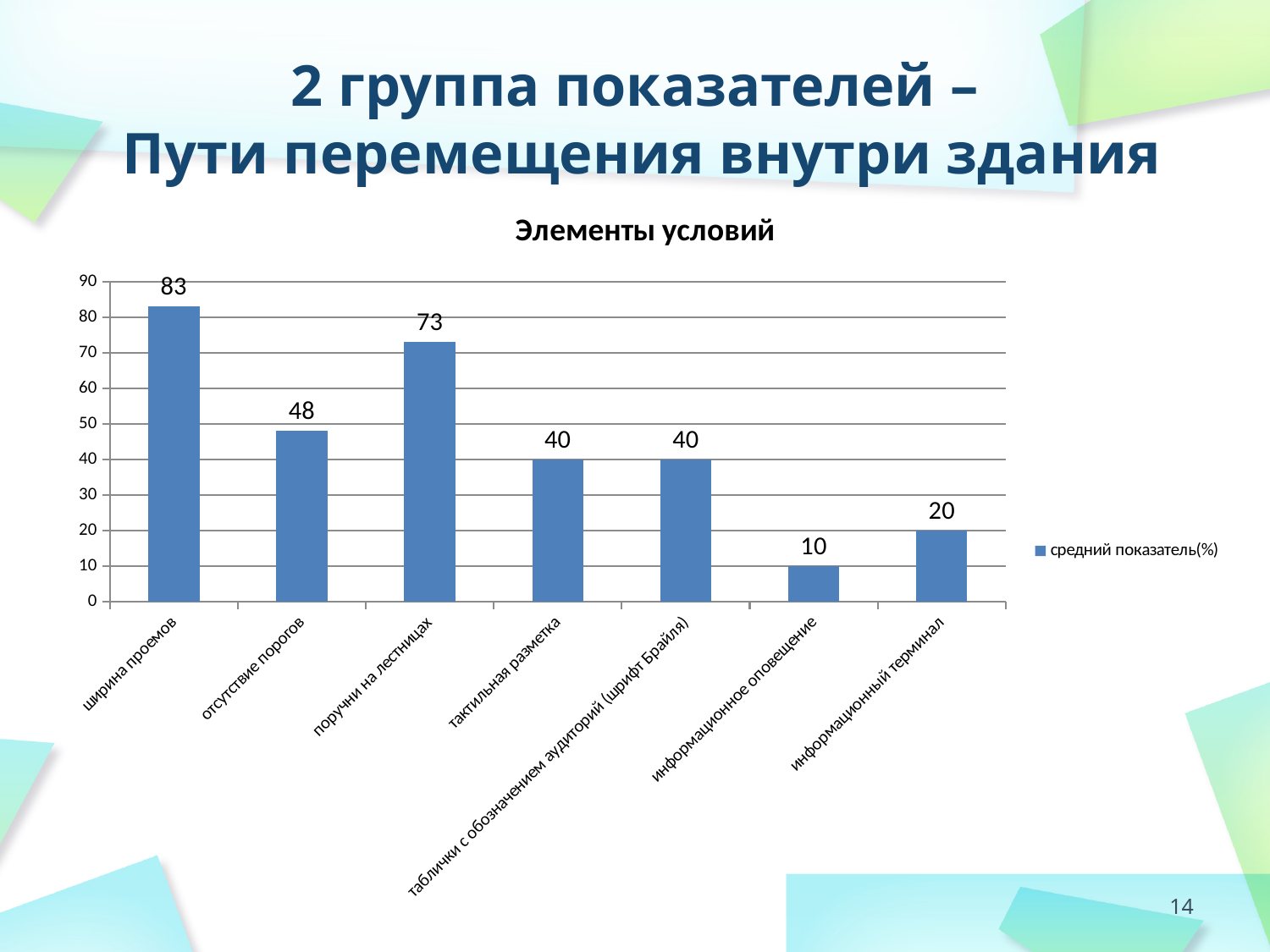
What is the value for информационное оповещение? 10 How many series does the legend list? 1 Which category has the lowest value? информационное оповещение How many categories are shown in the chart? 7 What is the title of the chart? Элементы условий What is the value for отсутствие порогов? 48 What kind of chart is shown on the slide? bar chart Which category has the highest value? ширина проемов What is the legend entry for the series? средний показатель(%) What is the value for ширина проемов? 83 What is the difference between the values for ширина проемов and поручни на лестницах? 10 Which is larger, the value for отсутствие порогов or the value for информационный терминал? отсутствие порогов